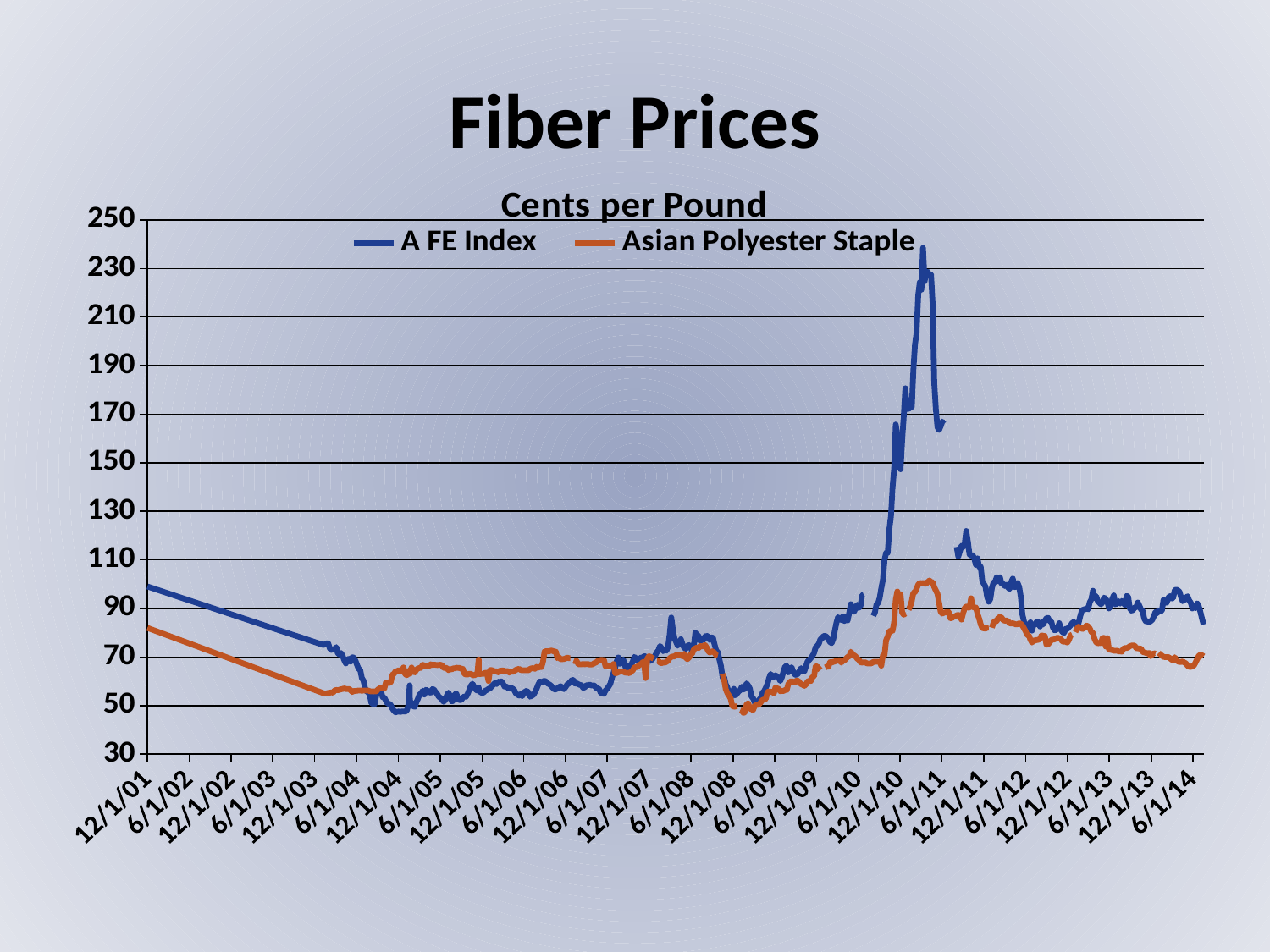
Which series reaches the higher peak in 2011, A FE Index or Asian Polyester Staple? A FE Index Which series is drawn in orange? Asian Polyester Staple What is the title shown above the chart's plot area? Cents per Pound Is the peak value of Asian Polyester Staple around 2011 greater or less than 110? less Is the value of Asian Polyester Staple around 12/1/08 greater or less than 70? less Does the A FE Index rise or fall between 12/1/01 and 12/1/03? fall Is the peak value of the A FE Index in 2011 greater or less than 210? greater At 12/1/01, which series has the higher value, A FE Index or Asian Polyester Staple? A FE Index What kind of chart is shown on the slide? line chart How many series does the chart legend list? 2